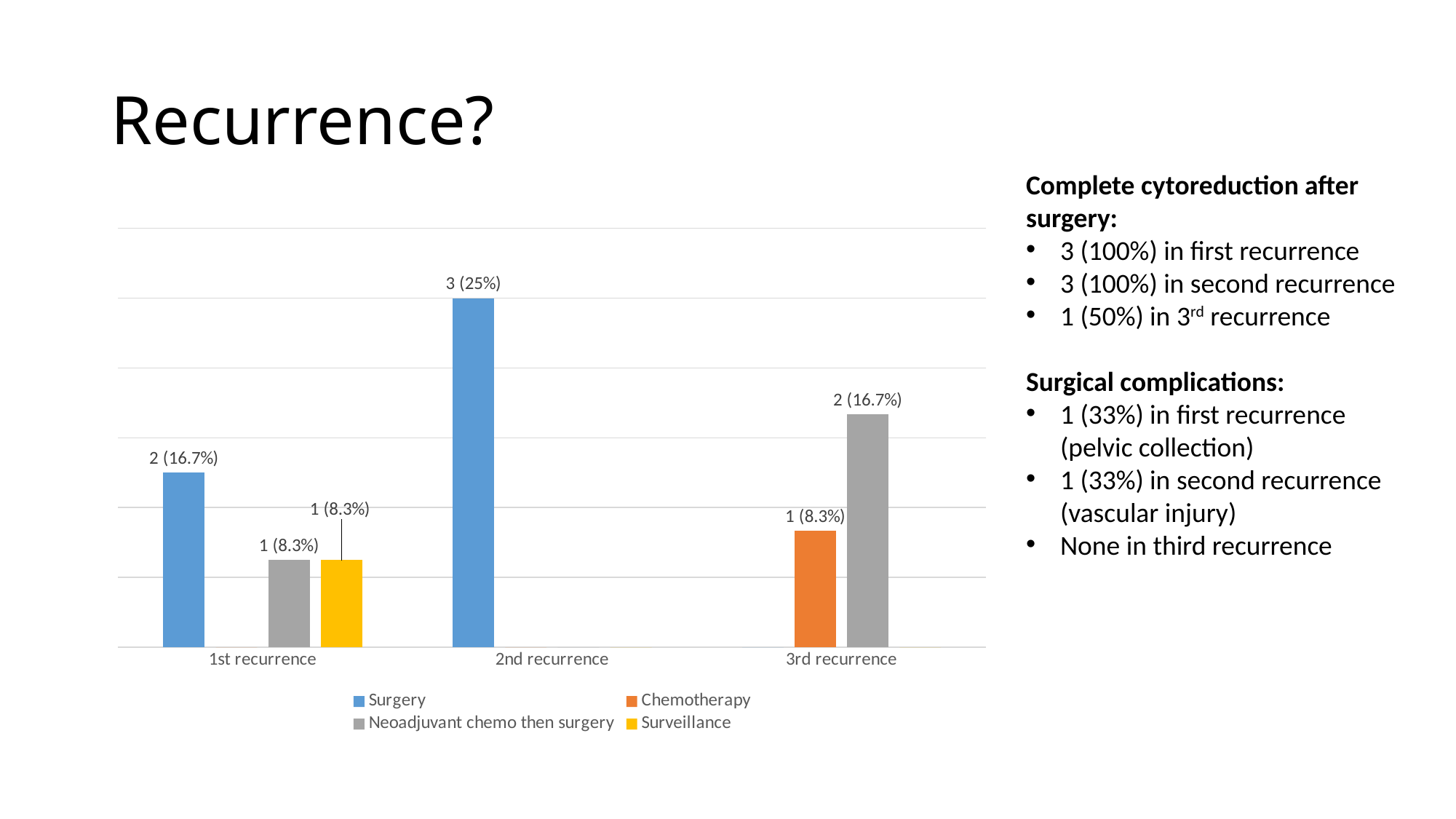
What is the value for Neoadjuvant chemo then surgery in the 3rd recurrence category? 2 (16.7%) What is the value for Surgery in the 2nd recurrence category? 3 (25%) Which series is shown in yellow in the legend? Surveillance How many recurrence categories are shown on the x axis? 3 What is the value for Surgery in the 1st recurrence category? 2 (16.7%) What is the value for Chemotherapy in the 3rd recurrence category? 1 (8.3%) Which category has the tallest bar in the chart? 2nd recurrence What is the difference in count between Surgery in 2nd recurrence and Surgery in 1st recurrence? 1 Which is larger: Surgery in 1st recurrence or Neoadjuvant chemo then surgery in 1st recurrence? Surgery in 1st recurrence What is the value for Surveillance in the 1st recurrence category? 1 (8.3%) How many series does the legend list? 4 What kind of chart is shown on the slide? Bar chart